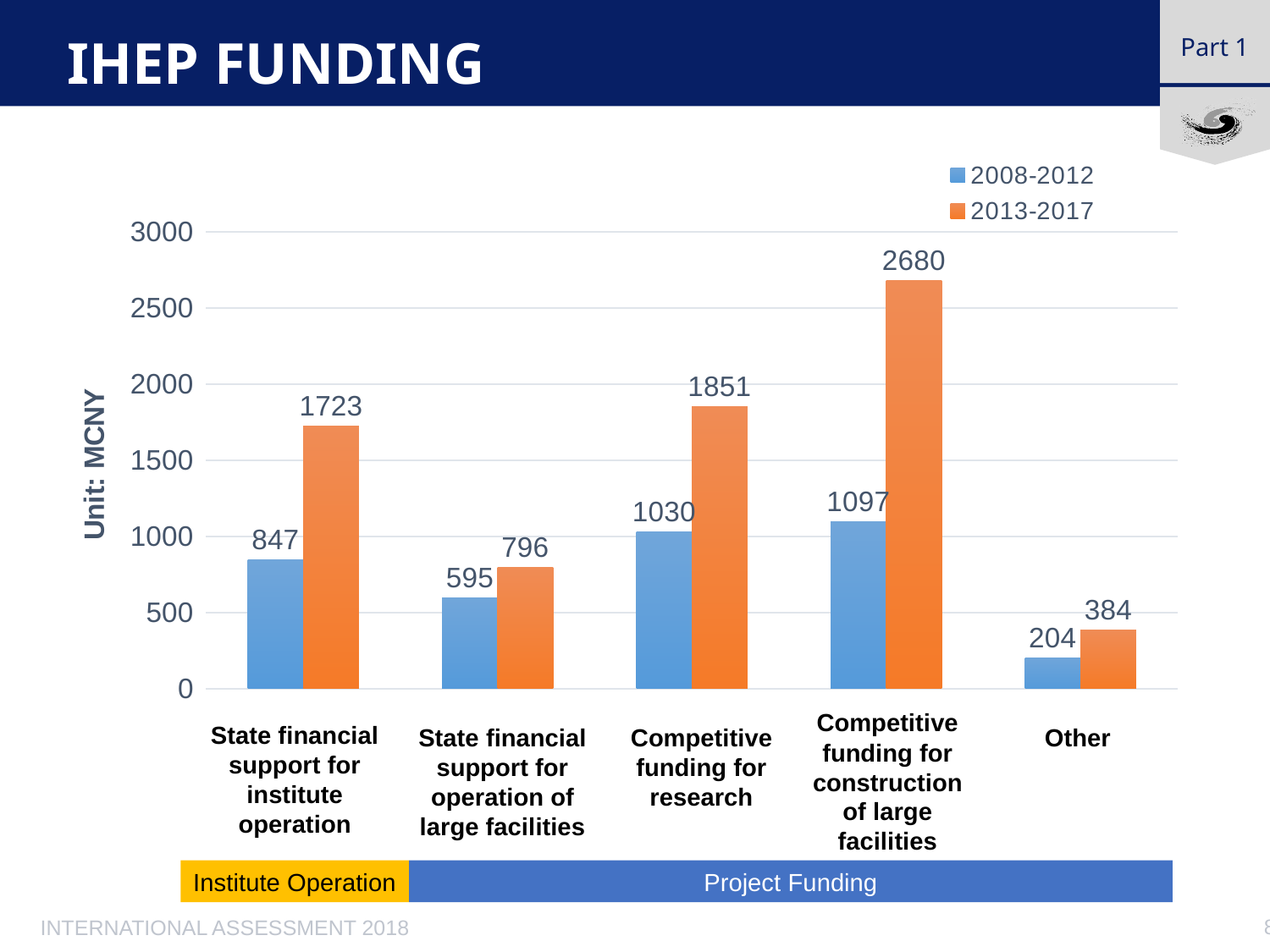
What is the 2013-2017 value for Other? 384 What kind of chart is shown on the slide? bar chart Which is larger: the 2008-2012 value for Competitive funding for construction of large facilities or the 2008-2012 value for Competitive funding for research? Competitive funding for construction of large facilities Which category has the highest 2013-2017 value? Competitive funding for construction of large facilities What unit is given on the y axis label? MCNY What is the 2013-2017 value for Competitive funding for construction of large facilities? 2680 How many series does the legend list? 2 What is the difference between the 2013-2017 and 2008-2012 values for Competitive funding for research? 821 How many categories are shown on the x axis? 5 Is the 2013-2017 value for State financial support for operation of large facilities greater or less than 1000? less Which category has the lowest 2008-2012 value? Other What is the 2008-2012 value for State financial support for institute operation? 847